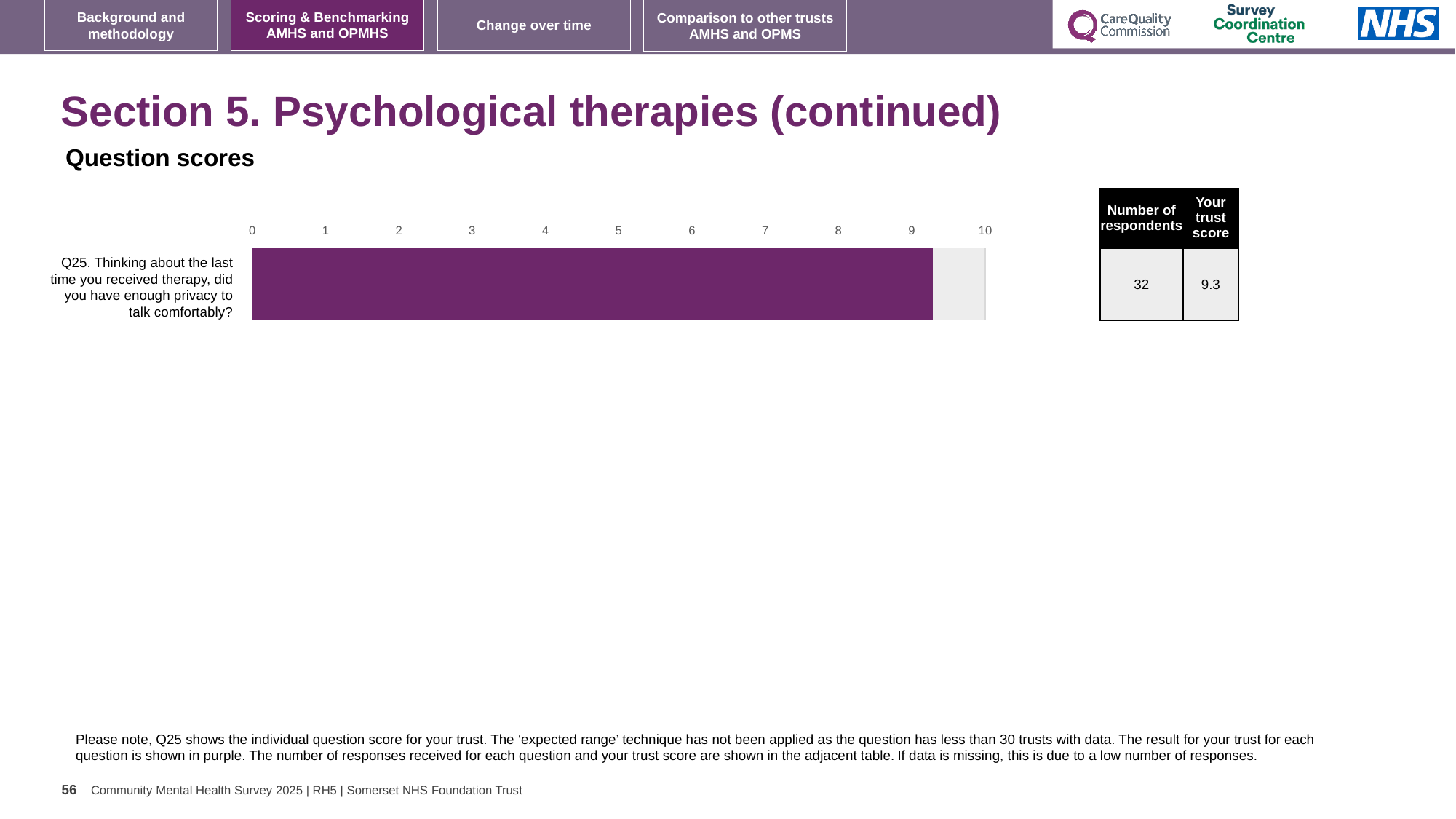
What is the maximum value shown on the chart's axis? 10 What kind of chart is shown on the slide? bar chart What colour is the bar for Q25? purple What is the trust score for Q25 shown on the slide? 9.3 How many questions (categories) are plotted in the chart? 1 How many respondents are listed for Q25 in the adjacent table? 32 Is the value for Q25 greater or less than 5? greater Is the value for Q25 greater or less than 10? less Is the value for Q25 greater or less than 9? greater